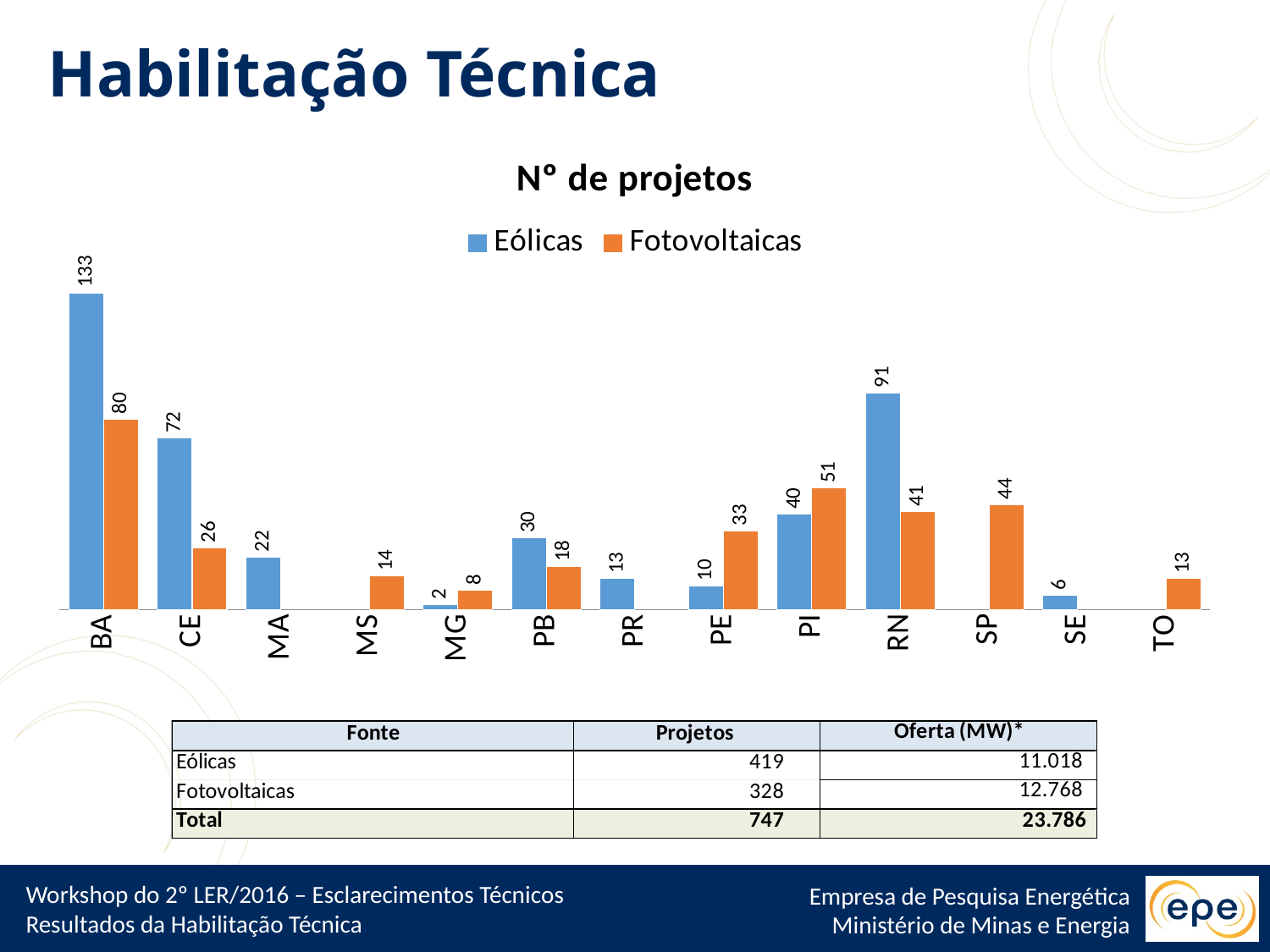
Which colour represents the Fotovoltaicas series in the chart? Orange How many states are shown on the x axis of the chart? 13 What is the number of Eólicas projects for BA? 133 Which is larger for PE: the number of Eólicas projects or the number of Fotovoltaicas projects? Fotovoltaicas How many series does the legend list? 2 Which state has the highest number of Eólicas projects? BA Which state has the highest number of Fotovoltaicas projects? BA What is the difference between the Eólicas and Fotovoltaicas project counts for RN? 50 What is the number of Fotovoltaicas projects for PI? 51 What is the title of the chart? Nº de projetos What kind of chart is shown on the slide? Bar chart What is the number of Fotovoltaicas projects for SP? 44